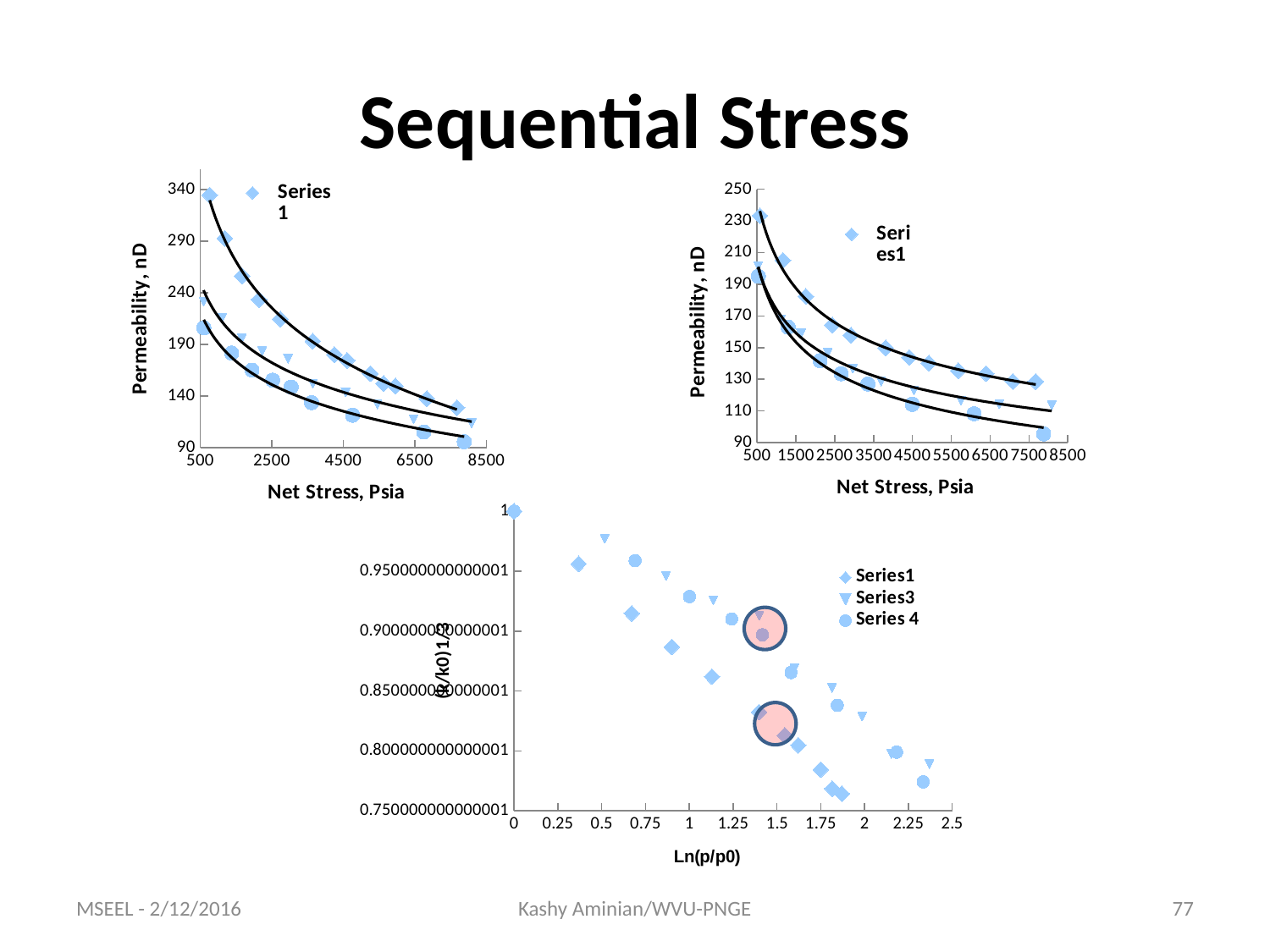
In the top-right chart, is the highest plotted permeability value greater or less than 210? greater What is the x-axis label of the top-right chart? Net Stress, Psia What kind of chart is the top-left chart on the slide? scatter chart What is the y-axis label of the top-left chart? Permeability, nD In the bottom chart, do the (k/k0)1/3 values rise or fall as Ln(p/p0) increases? fall In the top-left chart, do the permeability values rise or fall as net stress increases? fall In the bottom chart, what is the (k/k0)1/3 value plotted at Ln(p/p0) = 0? 1 In the top-right chart, do the permeability values rise or fall as net stress increases? fall How many series does the legend of the bottom chart list? 3 In the top-left chart, is the highest plotted permeability value greater or less than 290? greater How many series does the legend of the top-left chart list? 1 What kind of chart is the bottom chart with the Ln(p/p0) x axis? scatter chart